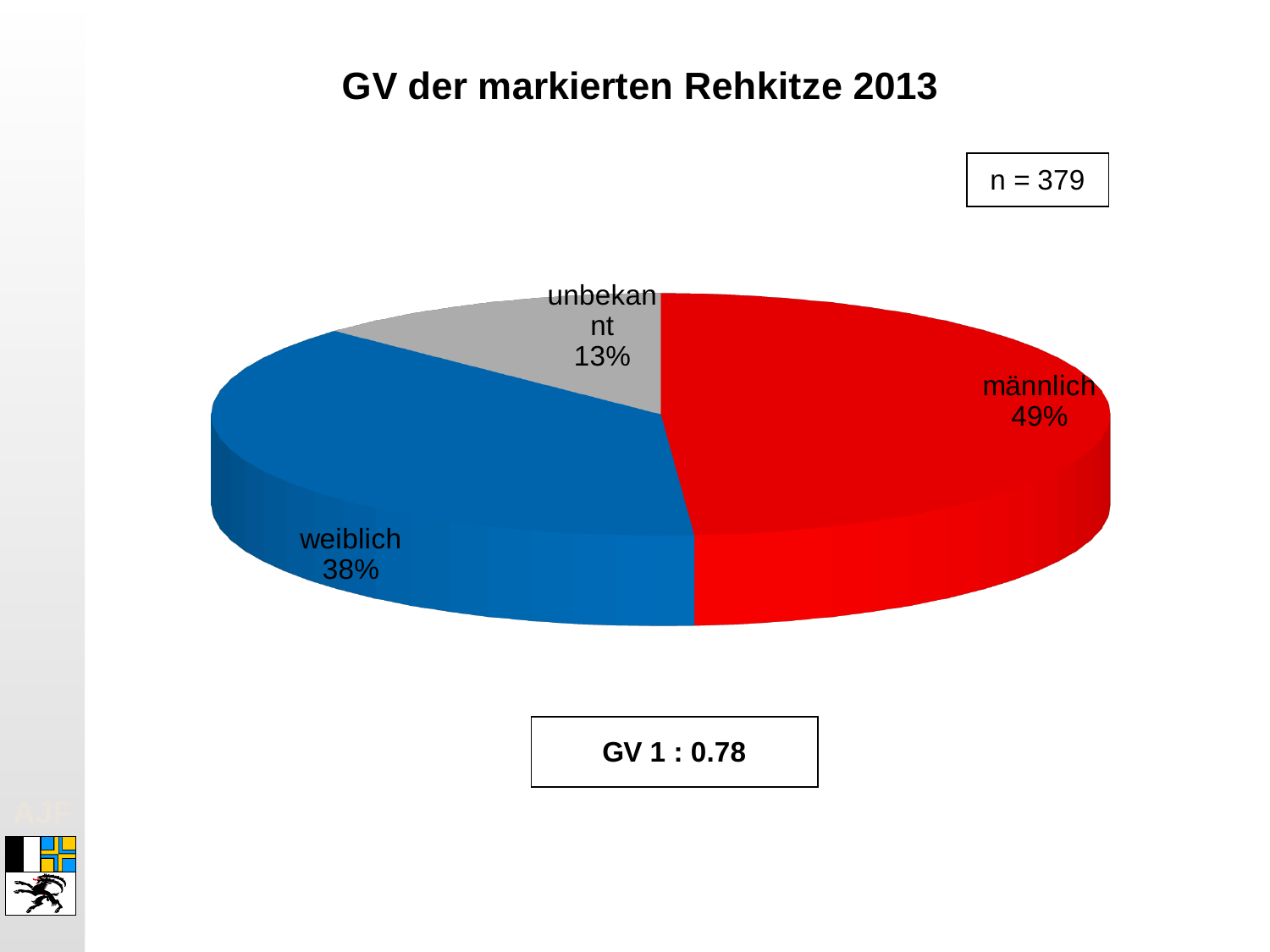
Which category has the smallest slice? unbekannt What is the share for männlich? 49% Which is larger, the share for weiblich or the share for unbekannt? weiblich Which category has the largest slice? männlich What is the share for weiblich? 38% What kind of chart is shown on the slide? pie chart How many slices does the pie chart have? 3 What is the difference in percentage points between weiblich and unbekannt? 25 What colour is the männlich slice? red What is the title of the chart? GV der markierten Rehkitze 2013 What is the share for unbekannt? 13% What is the difference in percentage points between männlich and weiblich? 11